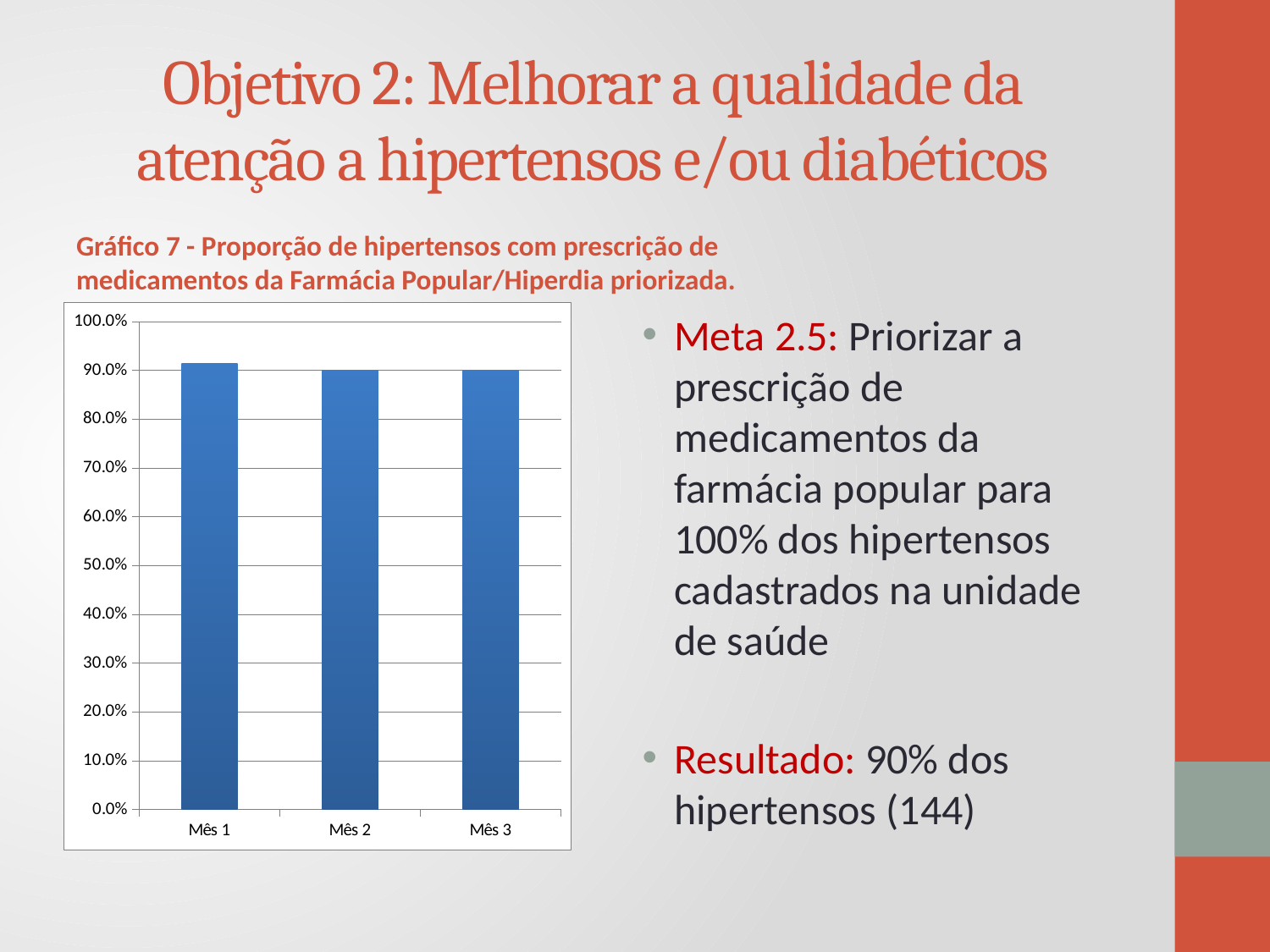
Is the value for Mês 2 greater or less than 50.0%? greater Which has the larger value, Mês 1 or Mês 2? Mês 1 What colour are the bars in the chart? blue Is the value for Mês 1 greater or less than 80.0%? greater How many categories (months) are plotted on the chart? 3 Is the value for Mês 3 greater or less than 60.0%? greater What is the title of the chart? Gráfico 7 - Proporção de hipertensos com prescrição de medicamentos da Farmácia Popular/Hiperdia priorizada. What is the value for Mês 3? 90.0% What kind of chart is shown on the slide? bar chart